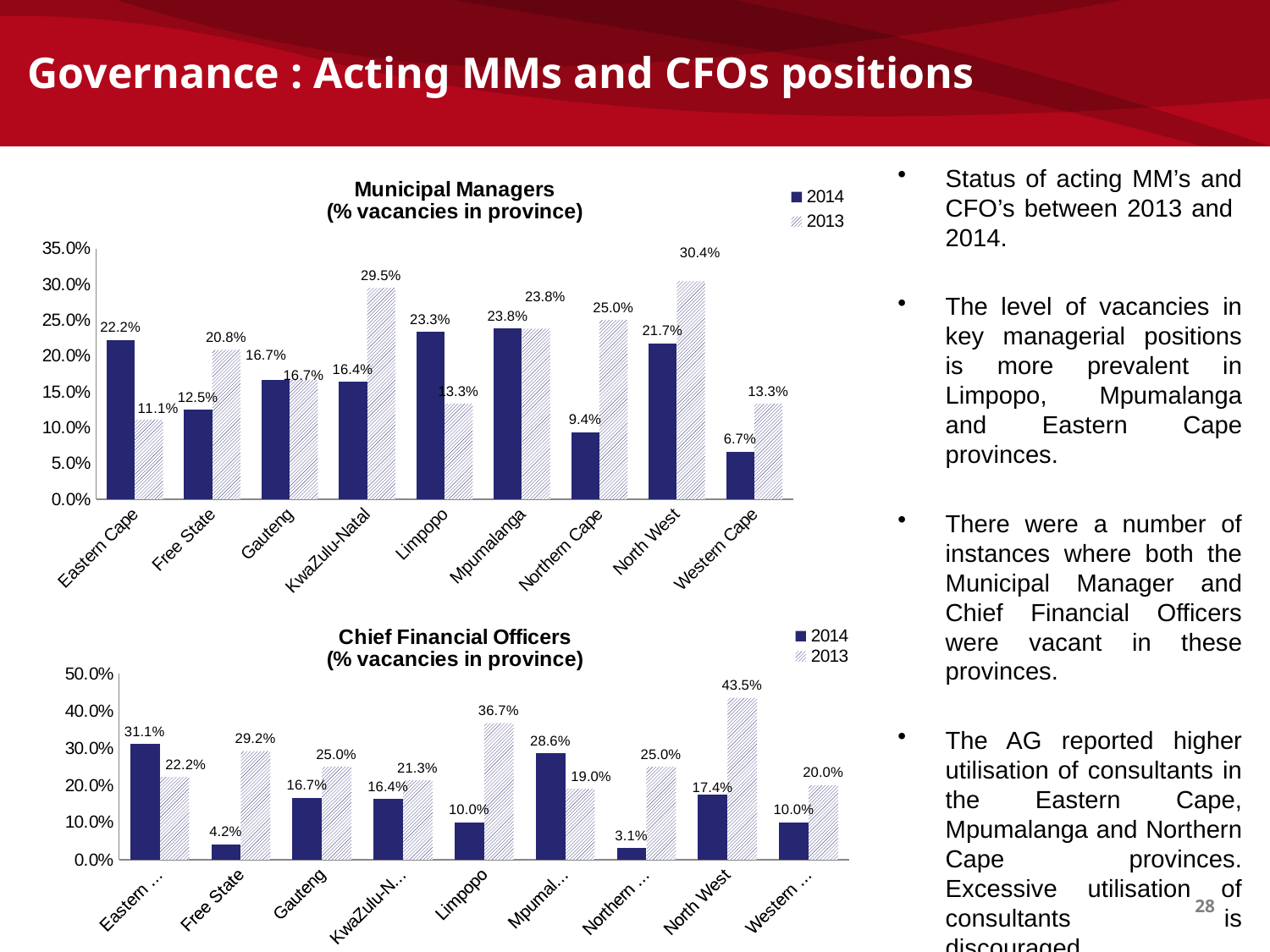
In the Chief Financial Officers chart, which province has the highest 2013 value? North West In the Municipal Managers chart, which is larger for Limpopo: the 2014 value or the 2013 value? 2014 How many series does the legend of the Chief Financial Officers chart list? 2 In the Chief Financial Officers chart, what is the 2013 value for North West? 43.5% In the Chief Financial Officers chart, what is the 2014 value for Free State? 4.2% In the Municipal Managers chart, which province has the lowest 2014 value? Western Cape In the Municipal Managers chart, what is the 2013 value for KwaZulu-Natal? 29.5% How many provinces are shown on the x axis of the Municipal Managers chart? 9 In the Chief Financial Officers chart, what is the difference between the 2013 and 2014 values for Limpopo? 26.7% In the Municipal Managers chart, which province has the highest 2013 value? North West In the Municipal Managers chart, what is the difference between the 2013 and 2014 values for Northern Cape? 15.6% In the Municipal Managers chart, what is the 2014 value for Eastern Cape? 22.2%